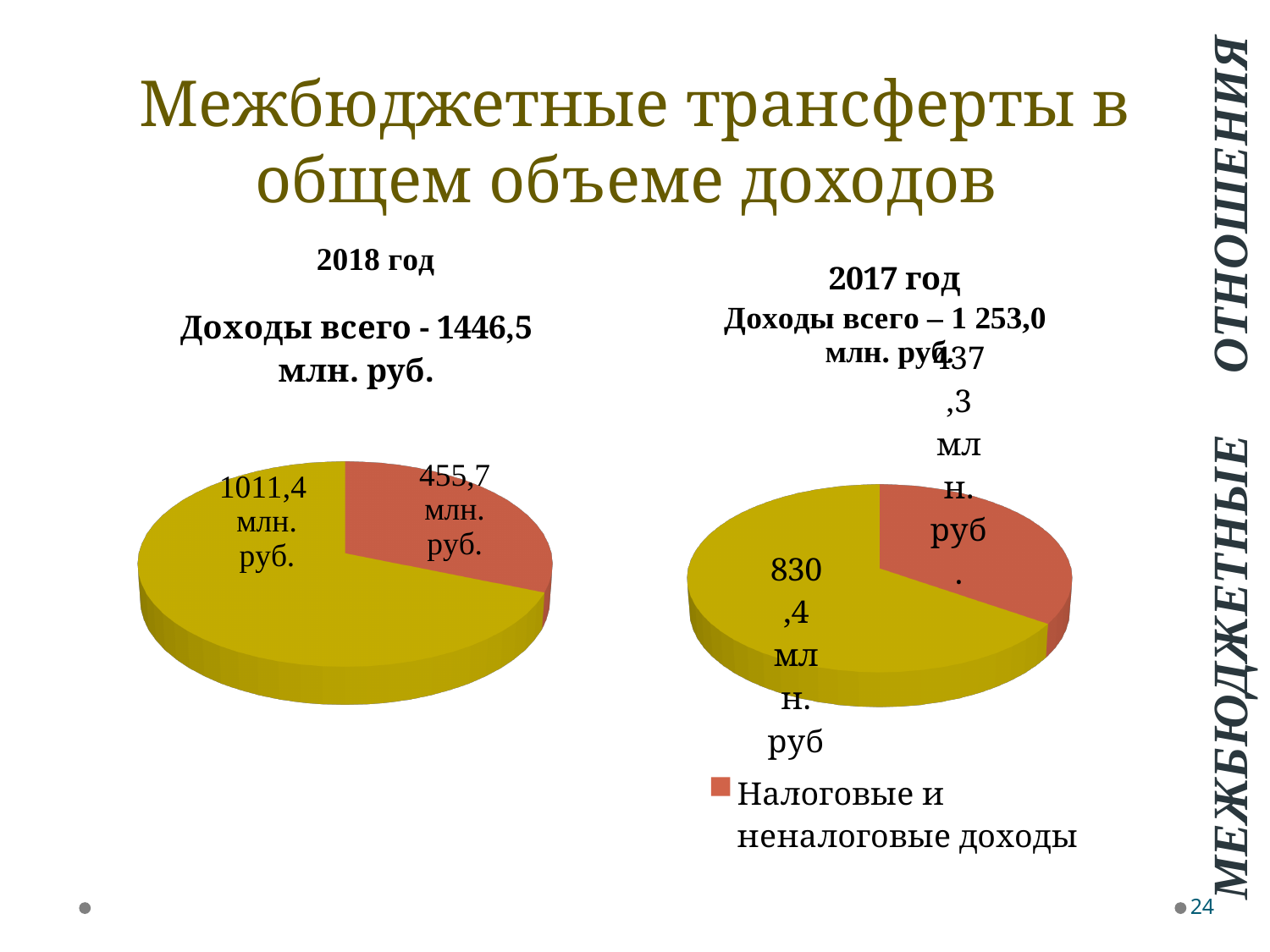
In the 2017 год pie chart, what value is labelled on the yellow slice? 830,4 млн. руб How many slices does the 2018 год pie chart have? 2 In the 2017 год pie chart, what value is labelled on the red slice (Налоговые и неналоговые доходы)? 437,3 млн. руб. What kind of chart is used for the 2018 год chart on the left? pie chart In the 2018 год pie chart, what value is labelled on the yellow slice? 1011,4 млн. руб. Is the red slice larger in the 2018 год chart (455,7) or in the 2017 год chart (437,3)? 2018 год In the 2018 год pie chart, what is the difference between the yellow slice (1011,4) and the red slice (455,7)? 555,7 млн. руб. In the 2018 год pie chart, what value is labelled on the red slice? 455,7 млн. руб. In the 2017 год pie chart, what is the difference between the yellow slice (830,4) and the red slice (437,3)? 393,1 млн. руб. Which legend entry is shown below the 2017 год pie chart? Налоговые и неналоговые доходы In the 2017 год pie chart, which is larger: the yellow slice or the red slice? the yellow slice In the 2018 год pie chart, which slice is the largest? the yellow slice (1011,4 млн. руб.)